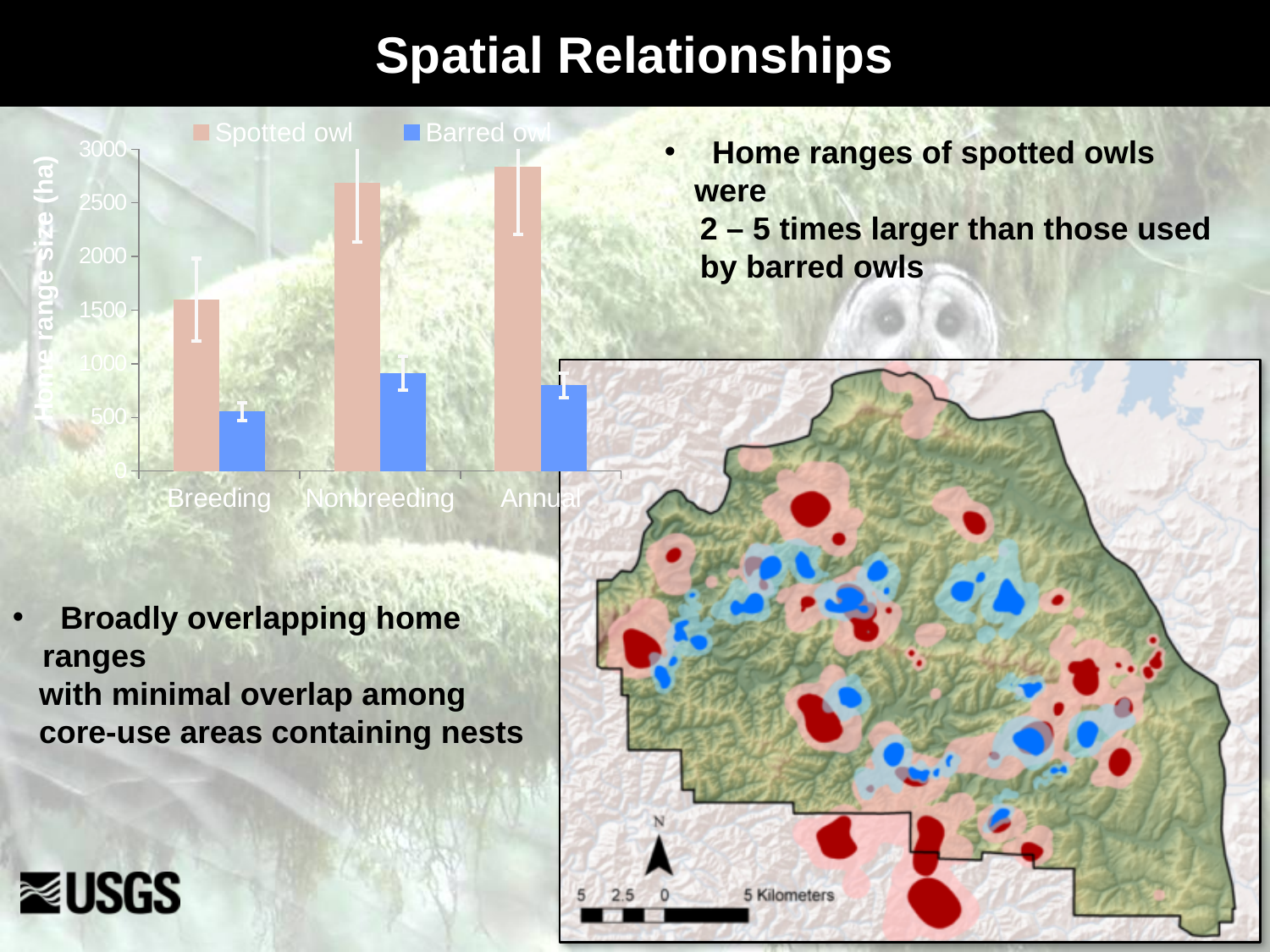
What kind of chart is shown on the slide? bar chart Is the Barred owl value for Annual greater or less than 500? greater Is the Barred owl value for Breeding greater or less than 1000? less Which series is shown in blue in the bar chart? Barred owl Do the Spotted owl values rise or fall from Breeding to Annual along the x axis? rise What is the label of the y axis of the bar chart? Home range size (ha) For the Spotted owl series, which category has the lowest value? Breeding For the Breeding category, which series has the larger value, Spotted owl or Barred owl? Spotted owl Is the Spotted owl value for Breeding greater or less than 1000? greater How many categories are shown on the x axis of the bar chart? 3 How many series does the chart legend list? 2